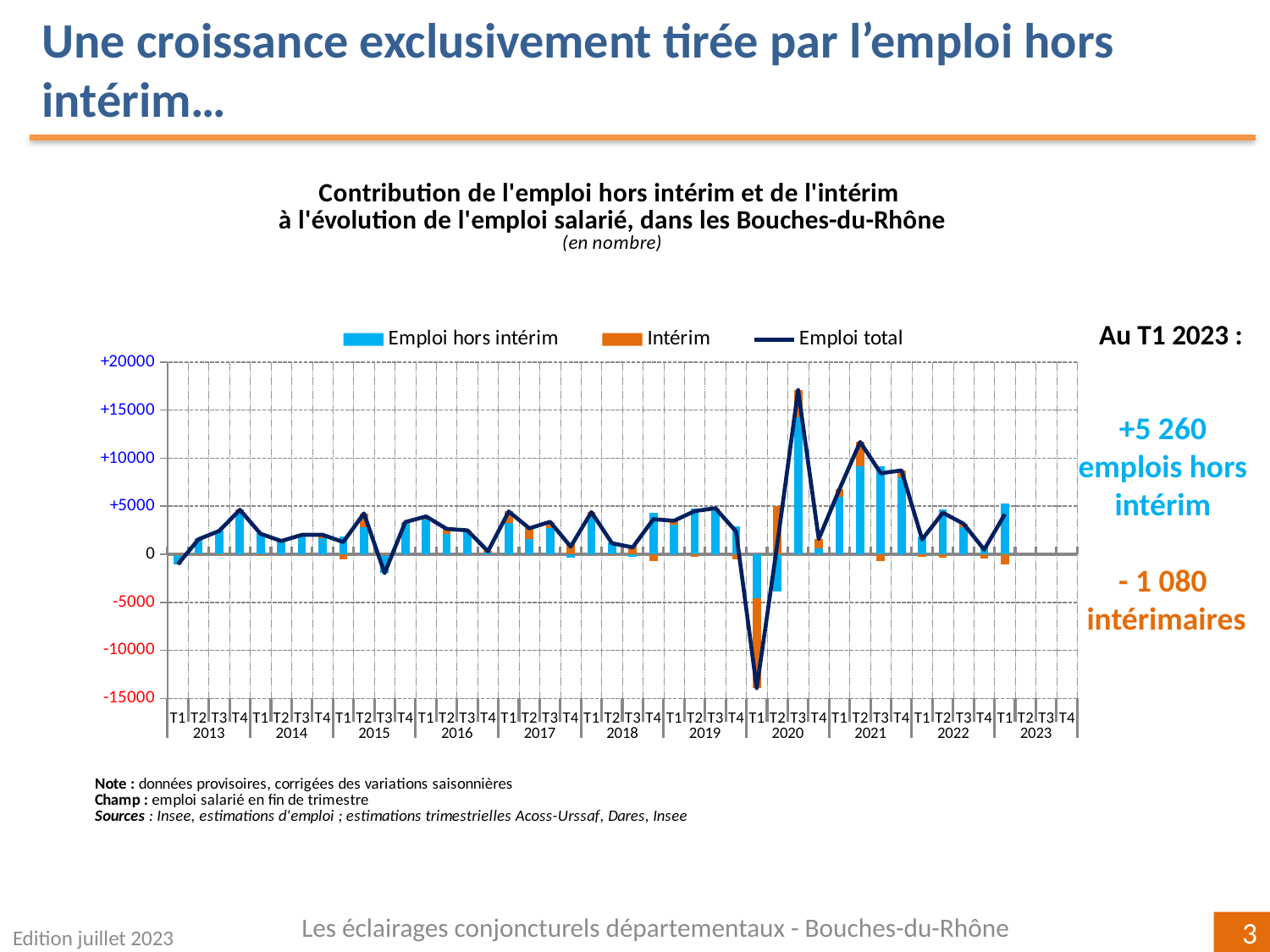
According to the annotation, what is the value for Emploi hors intérim at T1 2023? +5 260 Is the value of Emploi total at T1 2020 greater or less than -10000? less According to the annotation, what is the value for Intérim at T1 2023? - 1 080 Is the value of Emploi total at T3 2020 greater or less than +15000? greater What colour are the Intérim bars? Orange How many series does the legend list? 3 In which quarter does the Emploi total line reach its highest value? T3 2020 Does the Emploi total line rise or fall between T1 2020 and T3 2020? Rise In which quarter does the Emploi total line reach its lowest value? T1 2020 What kind of chart is shown on the slide? A bar chart combined with a line chart How many years are labelled on the x axis? 11 Which is larger, the Emploi total value at T3 2020 or at T2 2021? T3 2020